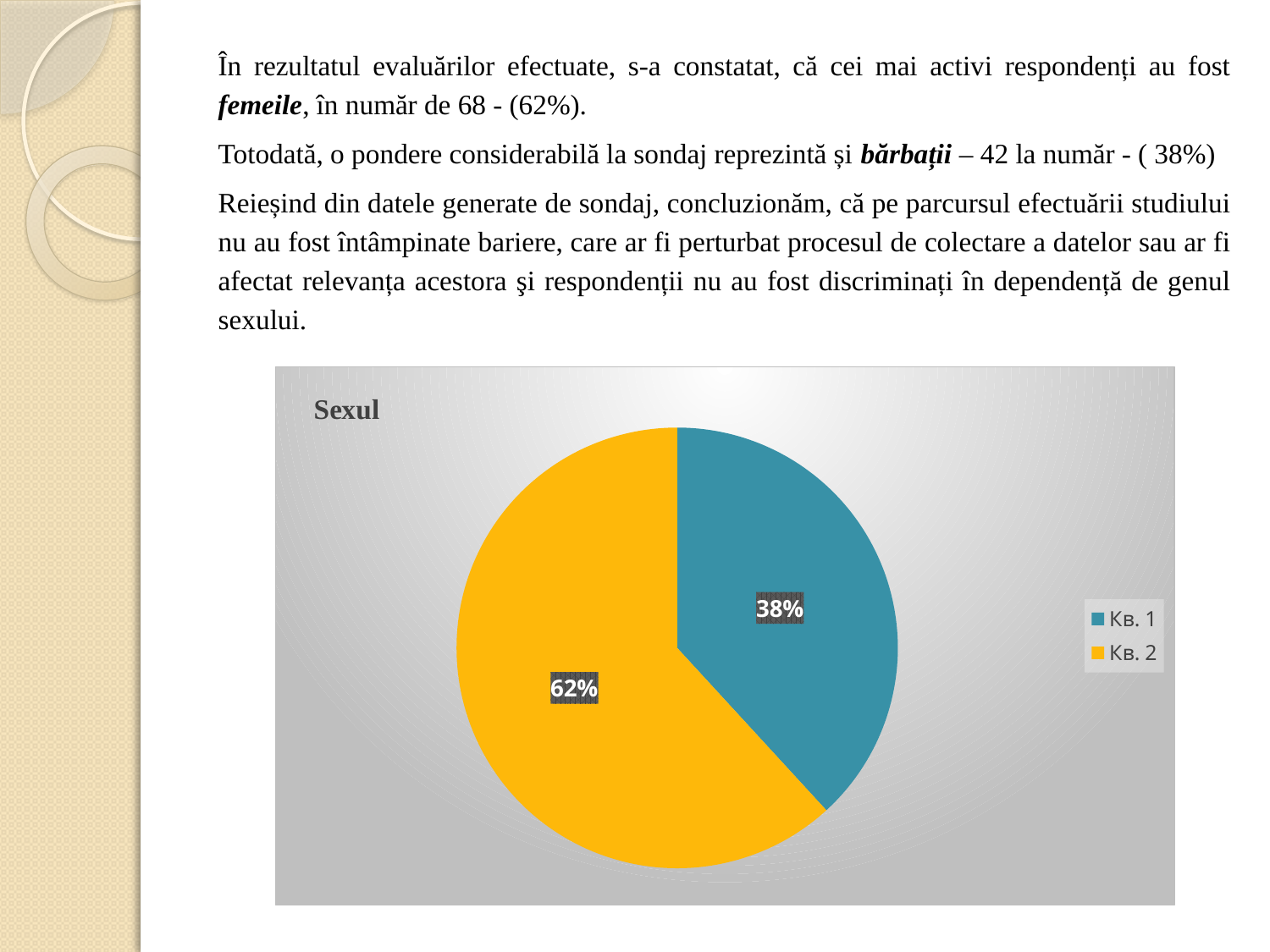
Which slice is the smallest in the pie chart? Кв. 1 What share of the pie does Кв. 1 represent? 38% How many slices does the pie chart have? 2 Which slice is the largest in the pie chart? Кв. 2 Which is larger, the Кв. 1 slice or the Кв. 2 slice? Кв. 2 What share of the pie does Кв. 2 represent? 62% How many entries does the legend list? 2 What is the title of the chart? Sexul What colour is the Кв. 2 slice? yellow What kind of chart is shown on the slide? pie chart What is the difference in percentage points between the Кв. 2 slice and the Кв. 1 slice? 24